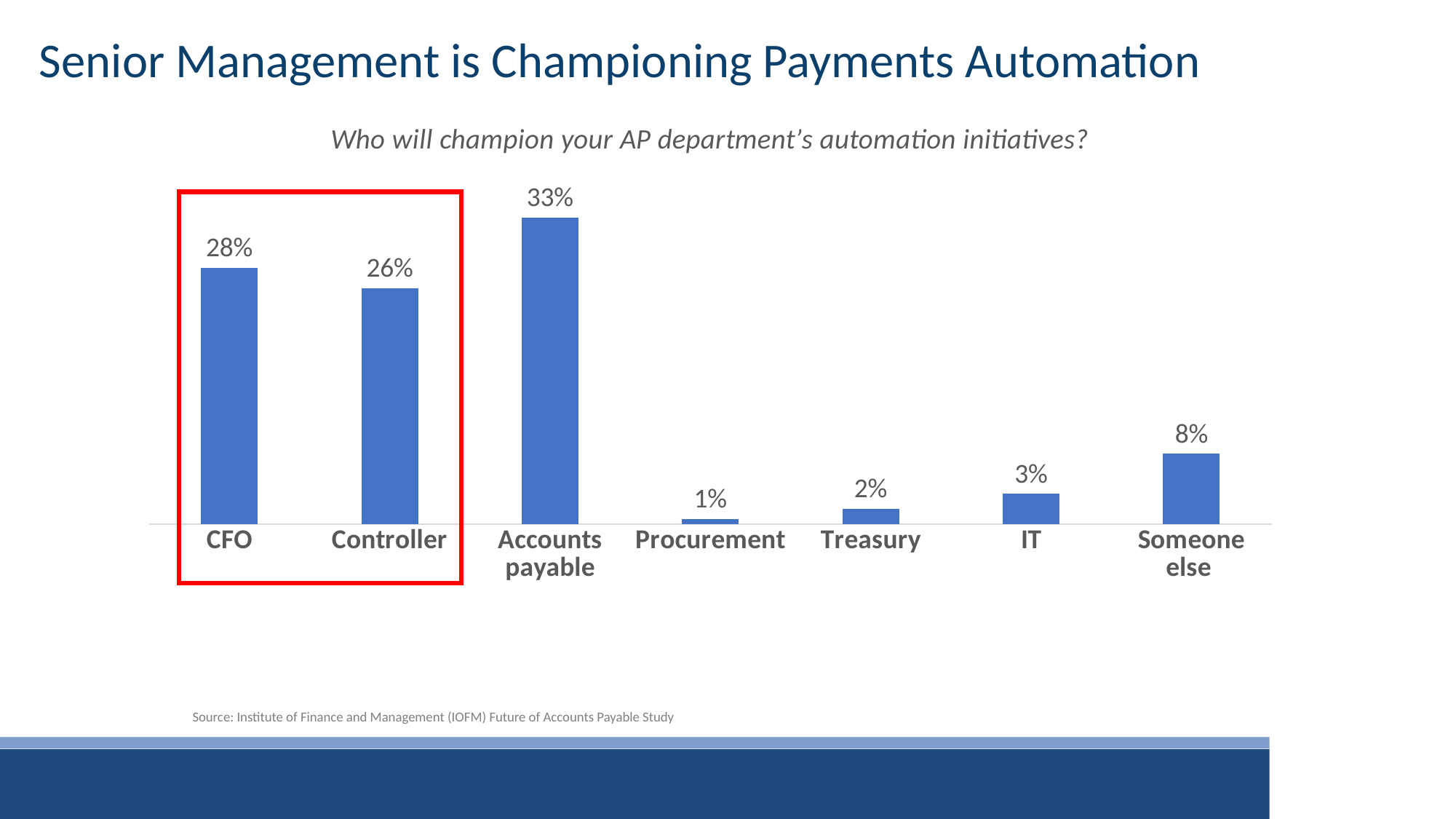
Which category has the lowest value in the chart? Procurement How many categories are shown in the chart? 7 What is the value shown for Controller? 26% What is the difference between the values for Accounts payable and CFO? 5% What is the value shown for Someone else? 8% What kind of chart is shown on the slide? Bar chart Which two categories are enclosed by the red box on the chart? CFO and Controller Which category has the highest value in the chart? Accounts payable What is the difference between the values for CFO and Controller? 2% What percentage of respondents said the CFO will champion their AP department's automation initiatives? 28% Which is larger, the value for IT or the value for Treasury? IT What is the value shown for Accounts payable? 33%